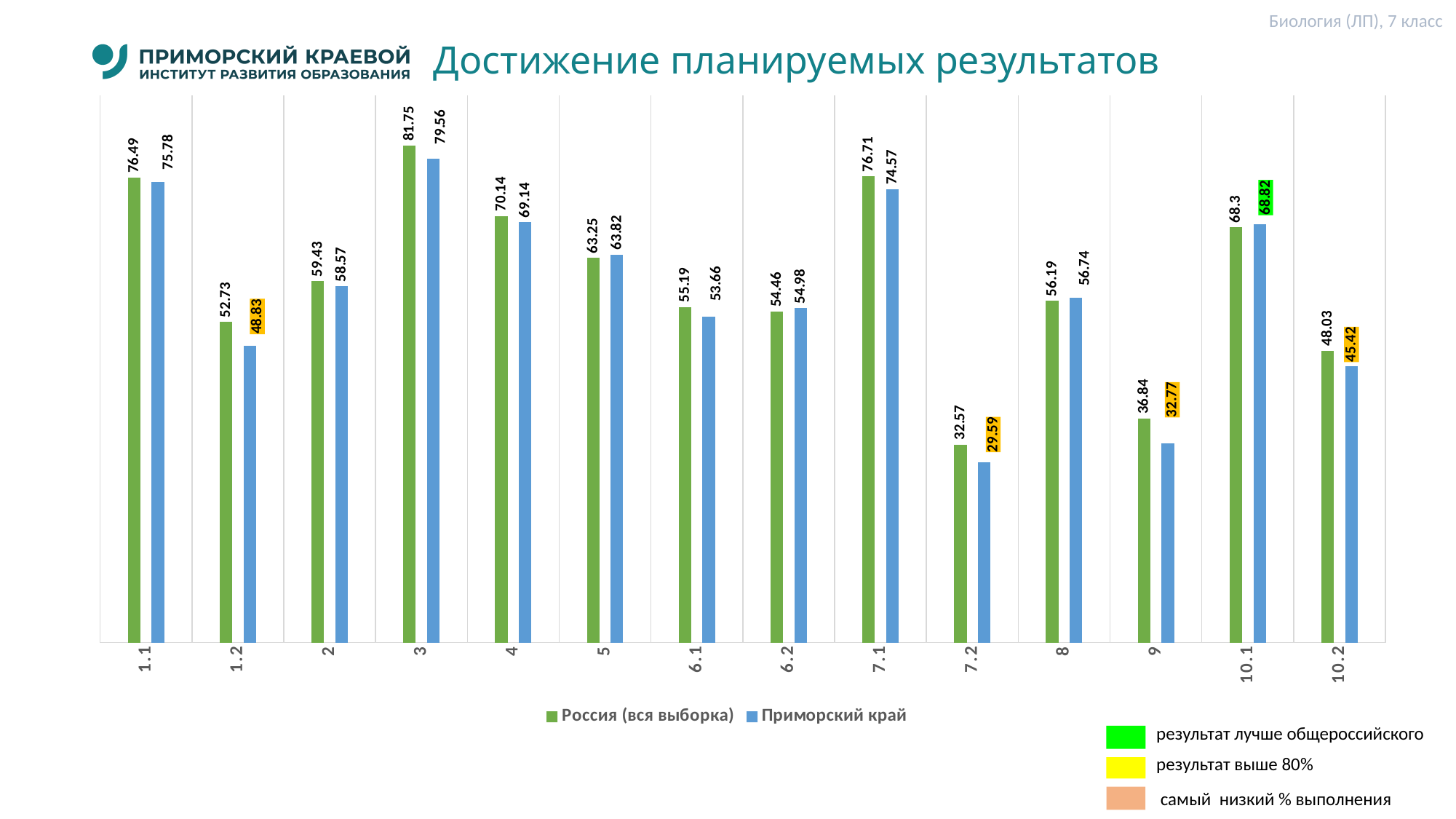
Which task has the lowest value for Приморский край? 7.2 For task 1.2, which is larger: Россия (вся выборка) or Приморский край? Россия (вся выборка) What is the title of the chart on the slide? Достижение планируемых результатов How many task categories are shown on the x axis of the chart? 14 What is the difference between Россия (вся выборка) and Приморский край for task 9? 4.07 What type of chart is shown on the slide? bar chart How many series does the chart legend list? 2 What is the value for Приморский край for task 10.1? 68.82 What is the value for Приморский край for task 1.2? 48.83 What is the difference between Россия (вся выборка) and Приморский край for task 7.2? 2.98 What is the value for Россия (вся выборка) for task 3? 81.75 Which task has the highest value for Россия (вся выборка)? 3